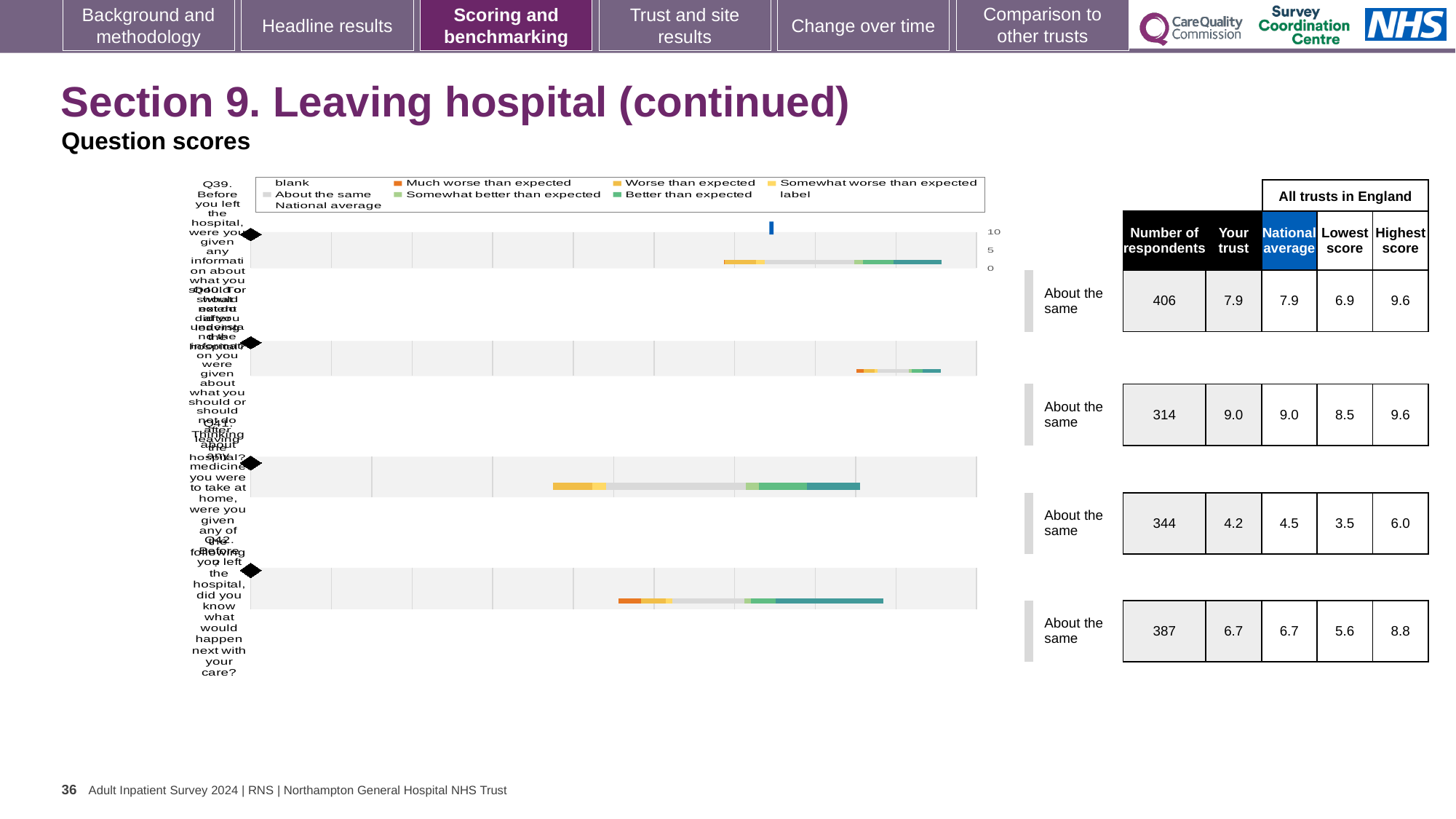
In the table beside the chart, for the third row, which is larger: the 'Your trust' score or the national average? national average In the table beside the chart, what is the difference between the highest score and the lowest score for the first row (Q39)? 2.7 How many question rows (bars) does the chart show? 4 What benchmark category is shown for every question row on the slide? About the same What kind of chart is shown on the slide? bar chart In the chart legend, what colour represents 'Much worse than expected'? orange In the chart legend, what colour represents 'Better than expected'? teal In the table beside the chart, which row has the lowest 'Your trust' score? the third row (4.2) In the table beside the chart, which row has the highest 'Your trust' score? the second row (9.0) In the table beside the chart, what is the 'Your trust' score for the last row (Q42)? 6.7 In the table beside the chart, what is the number of respondents for the first row (Q39)? 406